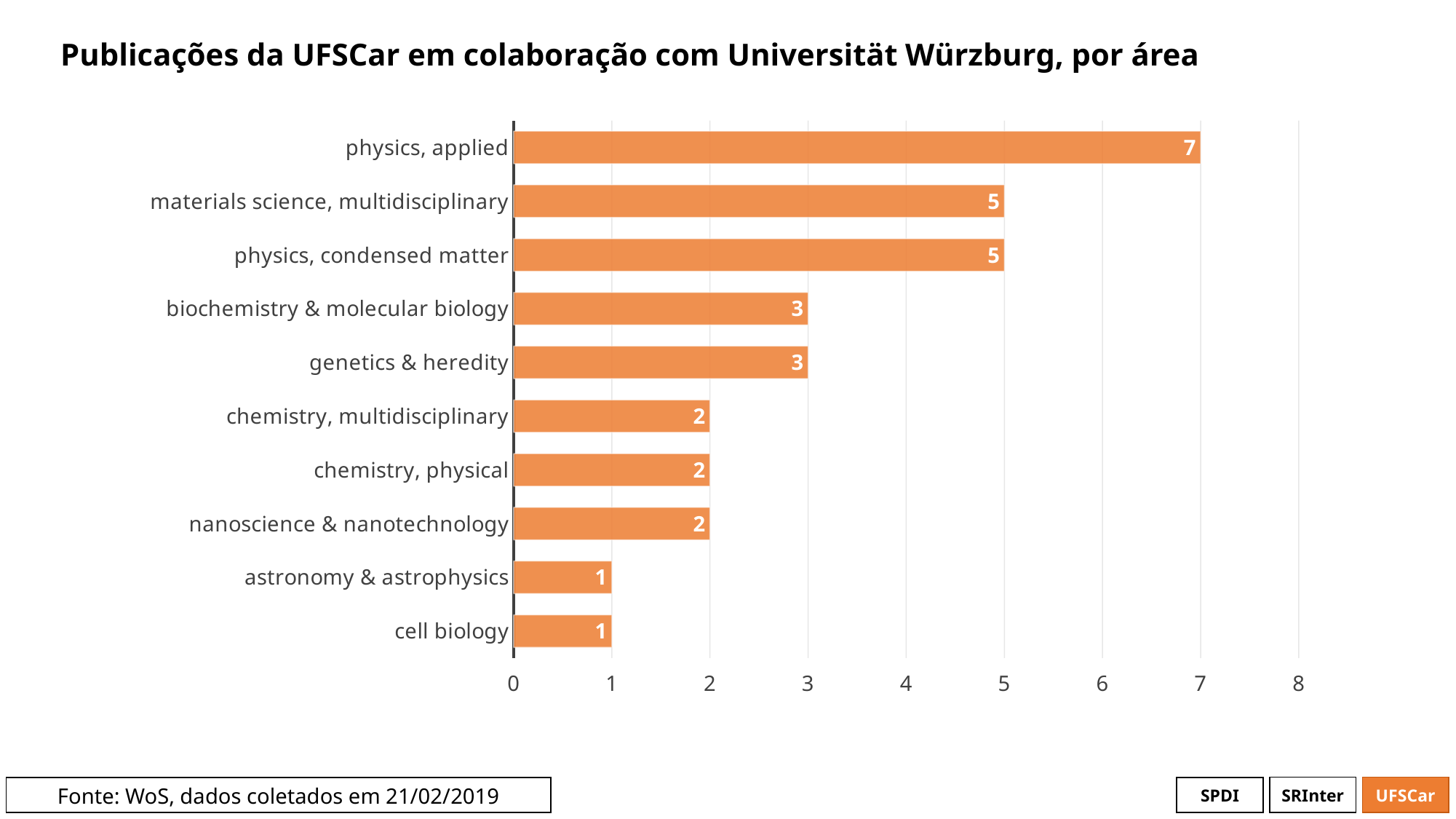
What kind of chart is shown on the slide? bar chart What is the value for biochemistry & molecular biology? 3 What is the value for nanoscience & nanotechnology? 2 What is the difference between the values for physics, applied and materials science, multidisciplinary? 2 Is the value for physics, applied greater or less than 6? greater What is the value for physics, applied? 7 How many areas are shown in the chart? 10 Which area has the highest number of publications? physics, applied What is the value for cell biology? 1 Which is larger, the value for physics, condensed matter or the value for chemistry, physical? physics, condensed matter What is the title of the chart? Publicações da UFSCar em colaboração com Universität Würzburg, por área What is the difference between the values for genetics & heredity and astronomy & astrophysics? 2